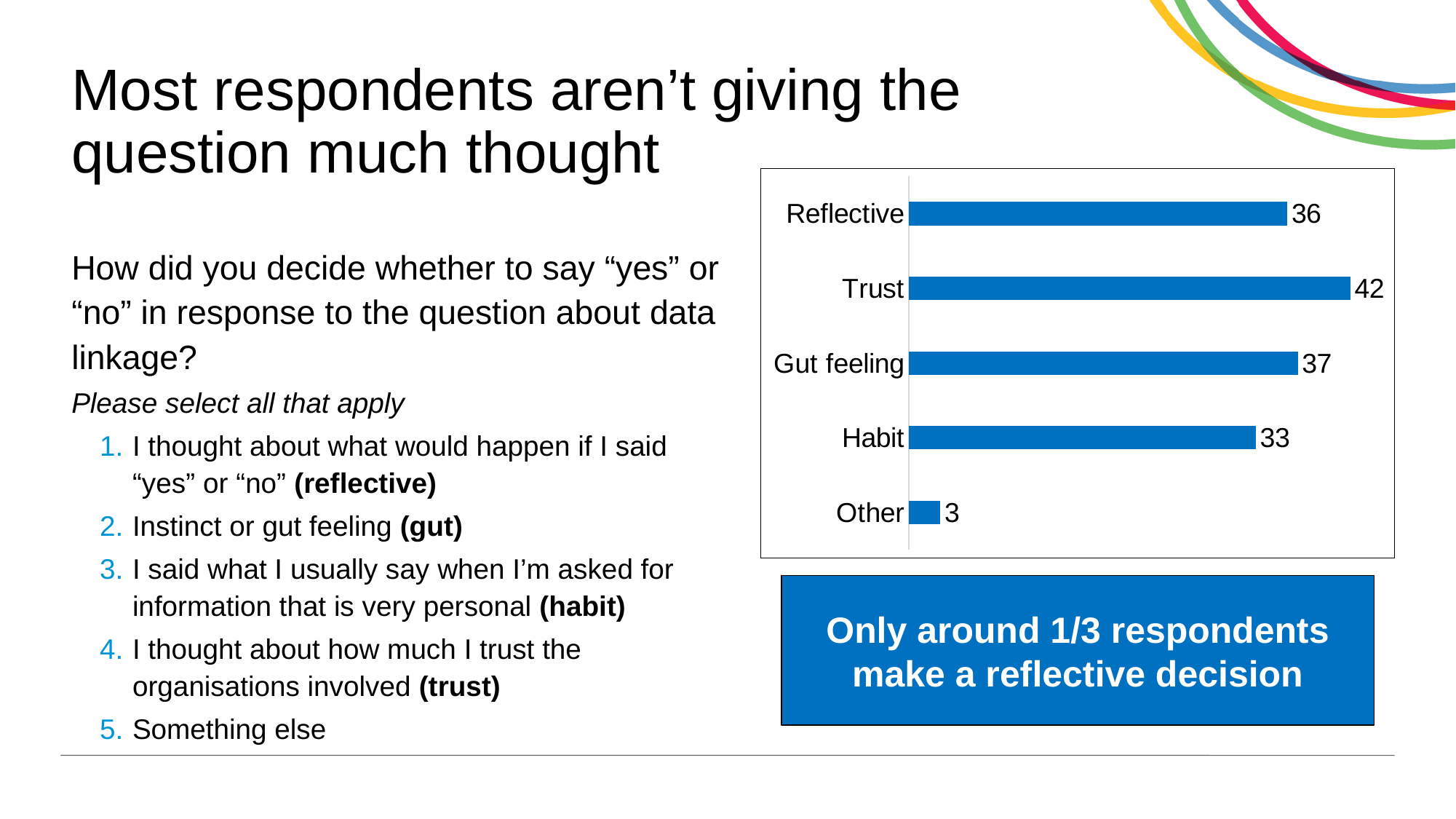
What kind of chart is shown on the slide? Bar chart What is the value for Other? 3 What colour are the bars in the chart? Blue Which category has the highest value? Trust What is the value for Reflective? 36 What is the value for Trust? 42 What is the difference between the values for Gut feeling and Reflective? 1 What is the difference between the values for Trust and Habit? 9 How many categories are shown in the chart? 5 Which is larger, the value for Habit or the value for Reflective? Reflective What is the value for Habit? 33 Which category has the lowest value? Other